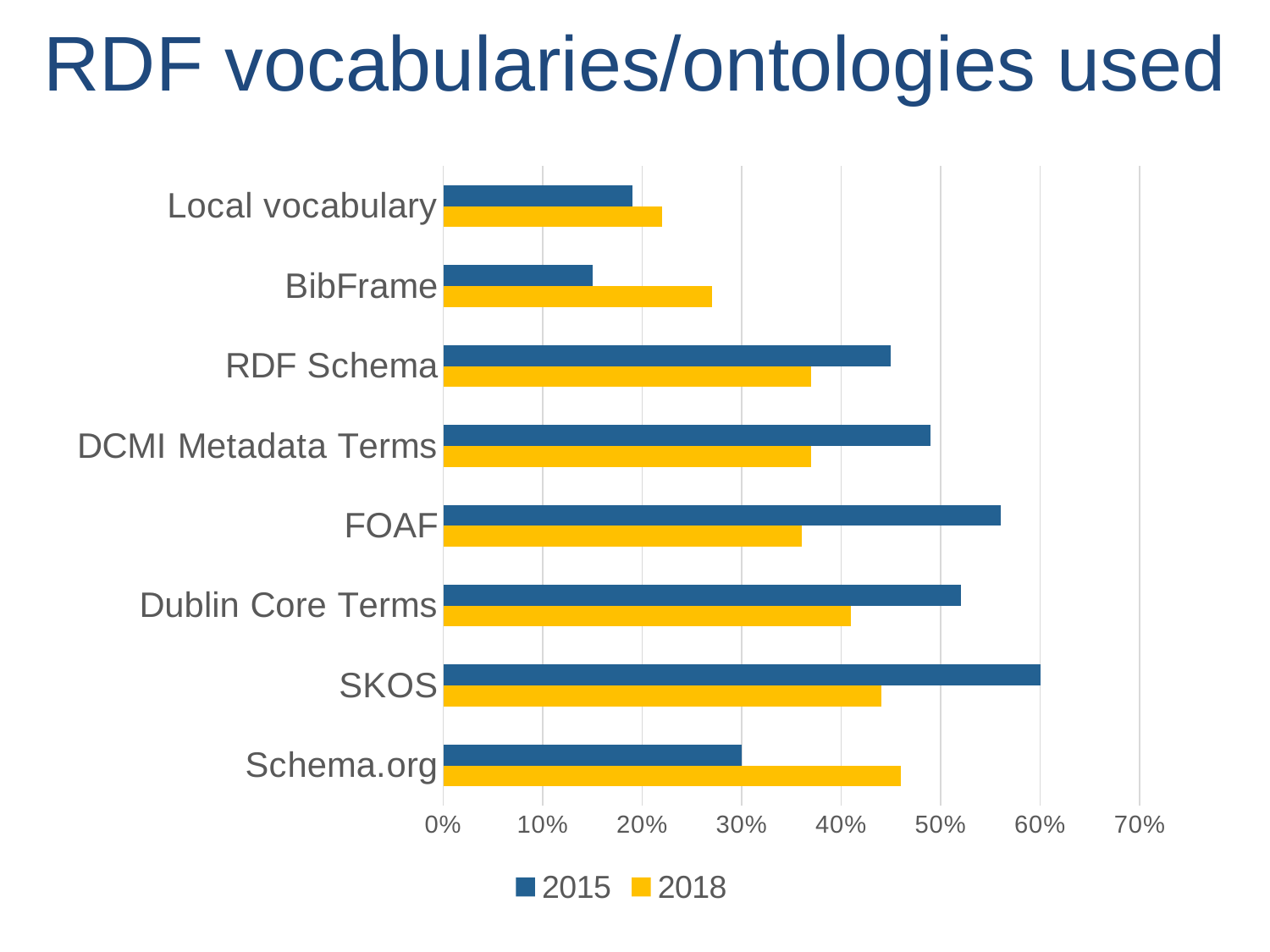
What is the title of the chart? RDF vocabularies/ontologies used For FOAF, which year has the larger value, 2015 or 2018? 2015 Is the 2015 value for FOAF greater or less than 50%? greater What kind of chart is shown on the slide? bar chart Which vocabulary has the lowest value for 2015? BibFrame Which vocabulary has the highest value for 2015? SKOS For Schema.org, which year has the larger value, 2015 or 2018? 2018 How many series does the legend list? 2 Which vocabulary has the highest value for 2018? Schema.org How many vocabularies/ontologies are listed on the chart? 8 Which vocabulary has the lowest value for 2018? Local vocabulary Is the 2018 value for BibFrame greater or less than 30%? less